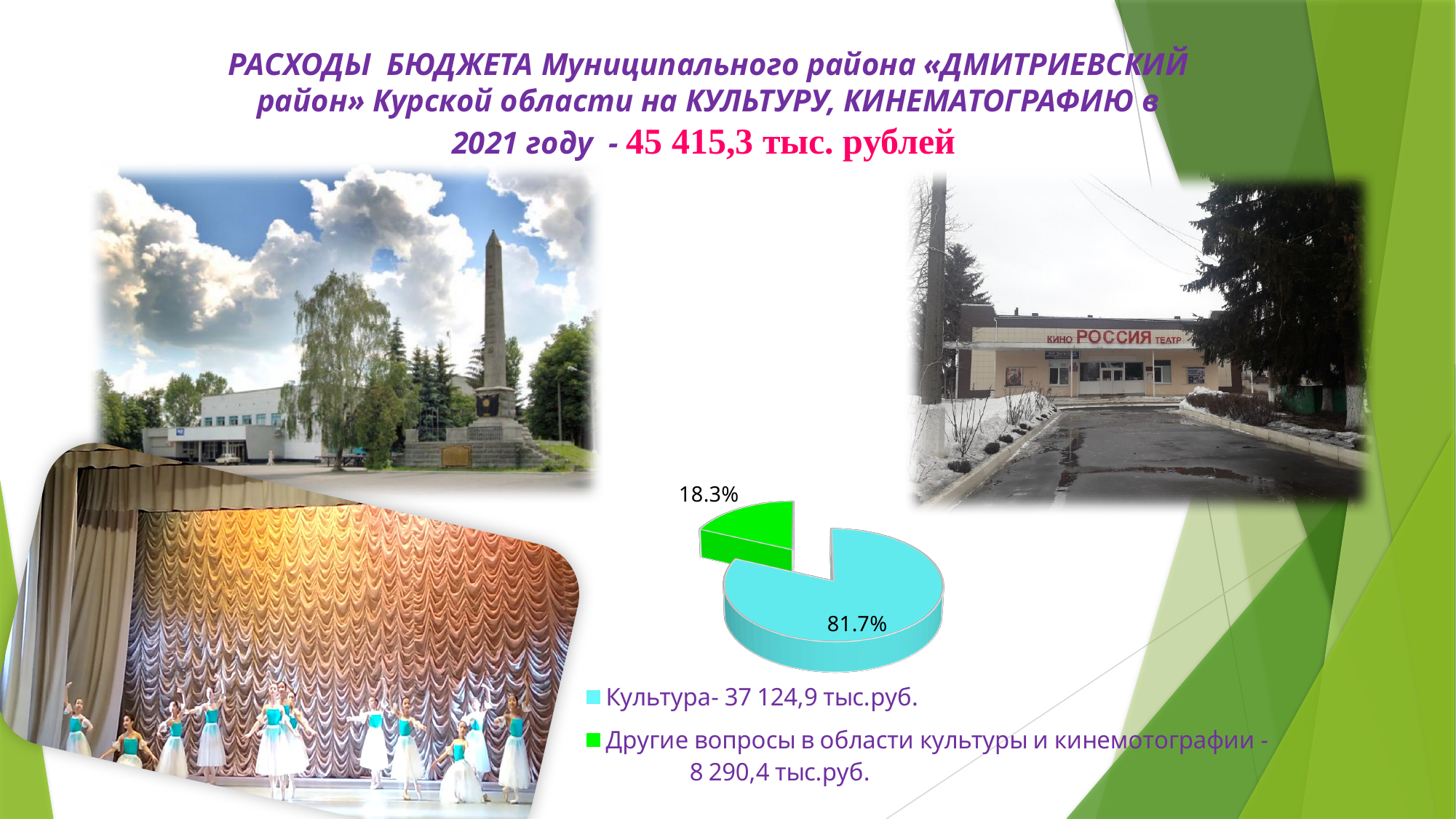
How many slices does the pie chart have? 2 Which is larger: the share for Культура or the share for Другие вопросы в области культуры и кинемотографии? Культура What colour is the Культура slice in the pie chart? light blue Which category has the smallest slice in the pie chart? Другие вопросы в области культуры и кинемотографии What amount in тыс.руб. does the legend give for Культура? 37 124,9 тыс.руб. By how many percentage points is the Культура share larger than the share for Другие вопросы в области культуры и кинемотографии? 63.4 What share of the pie does the slice for Другие вопросы в области культуры и кинемотографии represent? 18.3% What share of the pie does the Культура slice represent? 81.7% What kind of chart is shown on the slide? pie chart What amount in тыс.руб. does the legend give for Другие вопросы в области культуры и кинемотографии? 8 290,4 тыс.руб. Which category has the largest slice in the pie chart? Культура How many entries does the legend of the pie chart list? 2